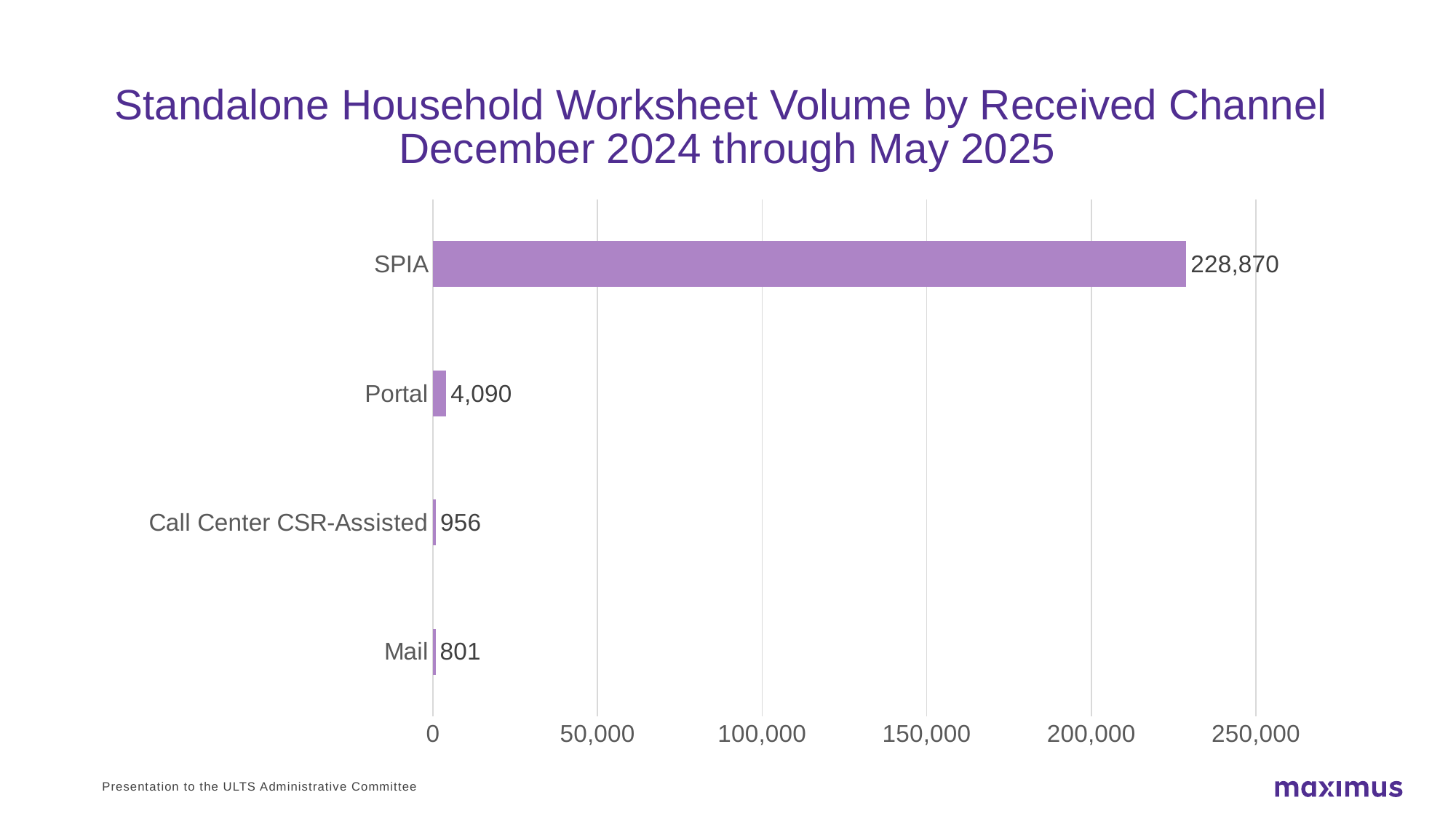
What is the difference between the SPIA and Portal volumes? 224,780 What is the volume for SPIA? 228,870 Is the value for SPIA greater or less than 200,000? greater How many channels are shown in the chart? 4 What is the volume for Portal? 4,090 Which has a larger volume, Portal or Call Center CSR-Assisted? Portal Which channel has the lowest volume? Mail What is the volume for Mail? 801 What is the difference between the Call Center CSR-Assisted and Mail volumes? 155 What is the volume for Call Center CSR-Assisted? 956 Which channel has the highest volume? SPIA What kind of chart is shown on the slide? Bar chart